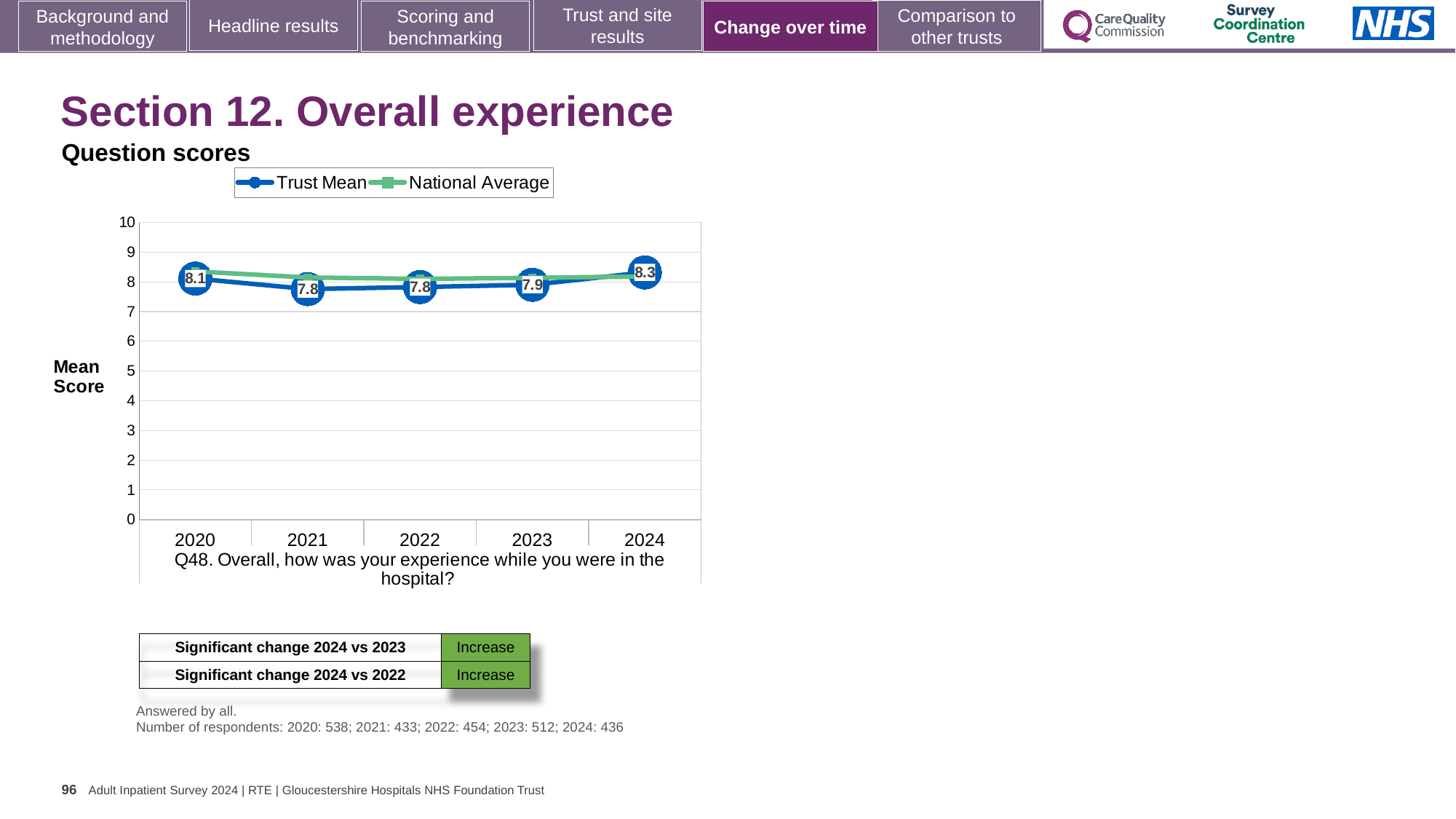
What is the difference between the Trust Mean score in 2024 and in 2020? 0.2 What is the Trust Mean score for 2023? 7.9 In which year is the Trust Mean score highest? 2024 Is the National Average value for 2020 greater or less than 8? greater What kind of chart is shown on the slide? Line chart How many years are plotted on the x axis? 5 Which year has the larger Trust Mean score, 2023 or 2024? 2024 What is the Trust Mean score for 2020? 8.1 Does the Trust Mean score rise or fall from 2021 to 2024? Rise How many series does the legend list? 2 What is the lowest Trust Mean score shown on the chart? 7.8 What is the Trust Mean score for 2024? 8.3